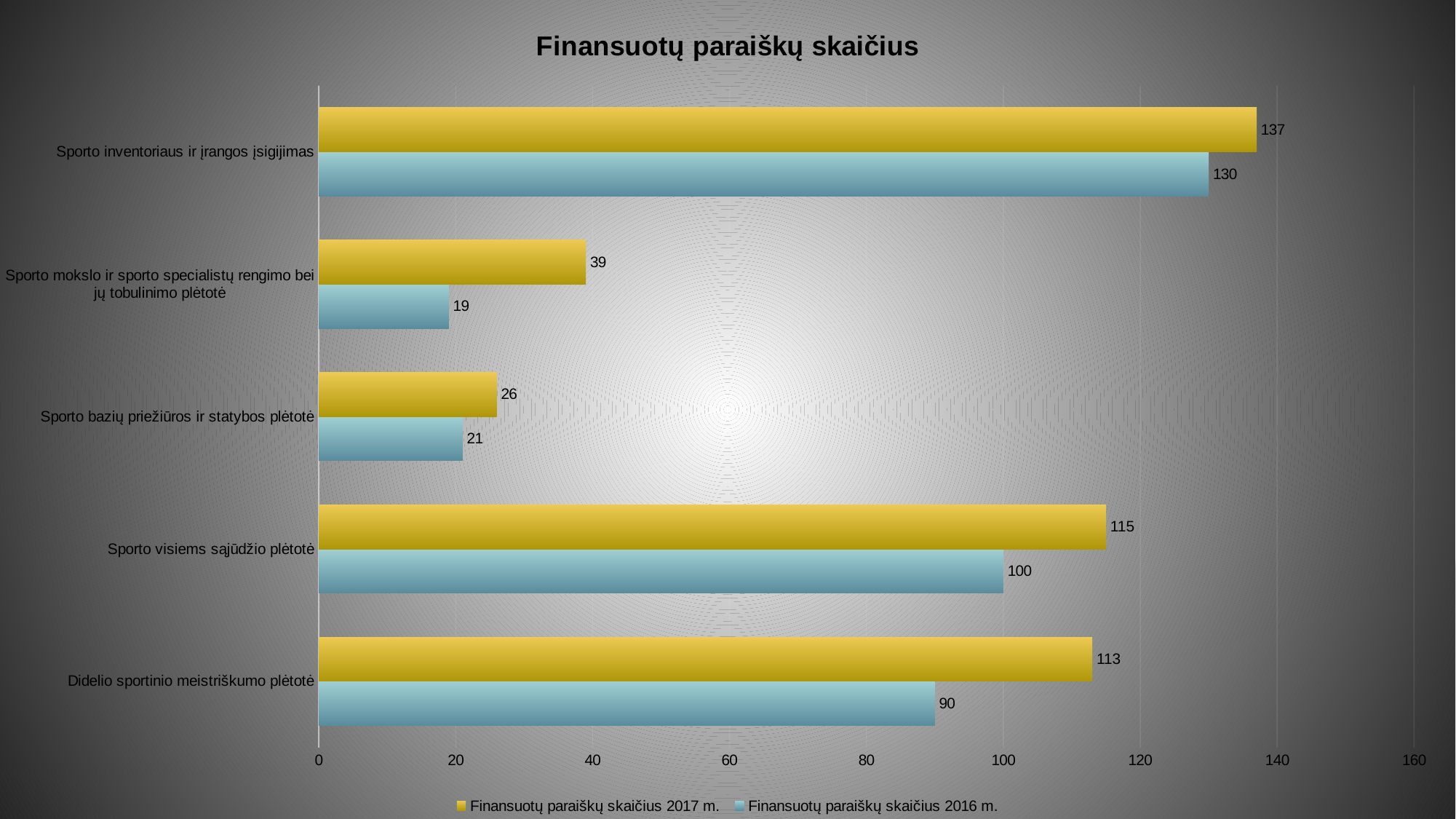
What is the value for Didelio sportinio meistriškumo plėtotė in the Finansuotų paraiškų skaičius 2016 m. series? 90 Which category has the lowest value in the Finansuotų paraiškų skaičius 2016 m. series? Sporto mokslo ir sporto specialistų rengimo bei jų tobulinimo plėtotė What type of chart is shown on the slide? Bar chart Which category has the highest value in the Finansuotų paraiškų skaičius 2017 m. series? Sporto inventoriaus ir įrangos įsigijimas What is the value for Sporto visiems sąjūdžio plėtotė in the Finansuotų paraiškų skaičius 2016 m. series? 100 What is the difference between the 2017 m. and 2016 m. values for Sporto mokslo ir sporto specialistų rengimo bei jų tobulinimo plėtotė? 20 Which is larger for Sporto bazių priežiūros ir statybos plėtotė: the 2017 m. value or the 2016 m. value? 2017 m. What is the difference between the 2017 m. and 2016 m. values for Didelio sportinio meistriškumo plėtotė? 23 How many series does the legend list? 2 What is the value for Sporto inventoriaus ir įrangos įsigijimas in the Finansuotų paraiškų skaičius 2017 m. series? 137 Is the 2016 m. value for Sporto inventoriaus ir įrangos įsigijimas greater or less than 120? greater How many categories are shown on the chart? 5